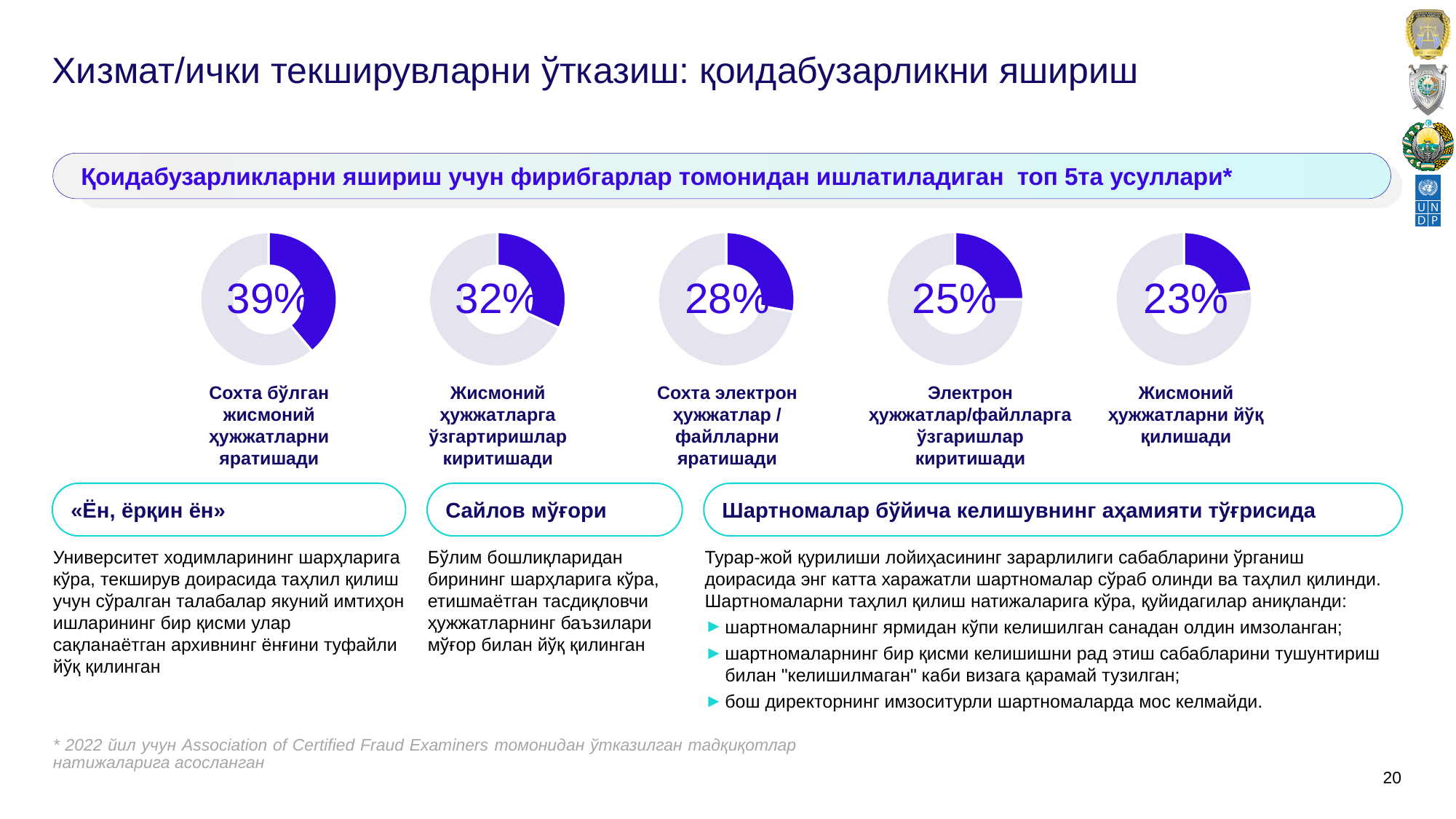
Which of the five methods has the highest percentage? Сохта бўлган жисмоний ҳужжатларни яратишади (39%) How many donut charts are shown on the slide? 5 Do the percentages in the donut charts increase or decrease from left to right? Decrease What percentage is shown in the donut chart labelled «Жисмоний ҳужжатларни йўқ қилишади»? 23% What percentage is shown in the donut chart labelled «Сохта бўлган жисмоний ҳужжатларни яратишади»? 39% Which is larger: the percentage for «Сохта электрон ҳужжатлар / файлларни яратишади» or for «Электрон ҳужжатлар/файлларга ўзгаришлар киритишади»? Сохта электрон ҳужжатлар / файлларни яратишади (28%) What type of chart is used to display the five percentages? Donut (pie) chart What percentage is shown in the donut chart labelled «Сохта электрон ҳужжатлар / файлларни яратишади»? 28% What percentage is shown in the donut chart labelled «Жисмоний ҳужжатларга ўзгартиришлар киритишади»? 32% What percentage is shown in the donut chart labelled «Электрон ҳужжатлар/файлларга ўзгаришлар киритишади»? 25% What is the difference between the highest percentage (39%) and the lowest percentage (23%) shown in the donut charts? 16% Which of the five methods has the lowest percentage? Жисмоний ҳужжатларни йўқ қилишади (23%)